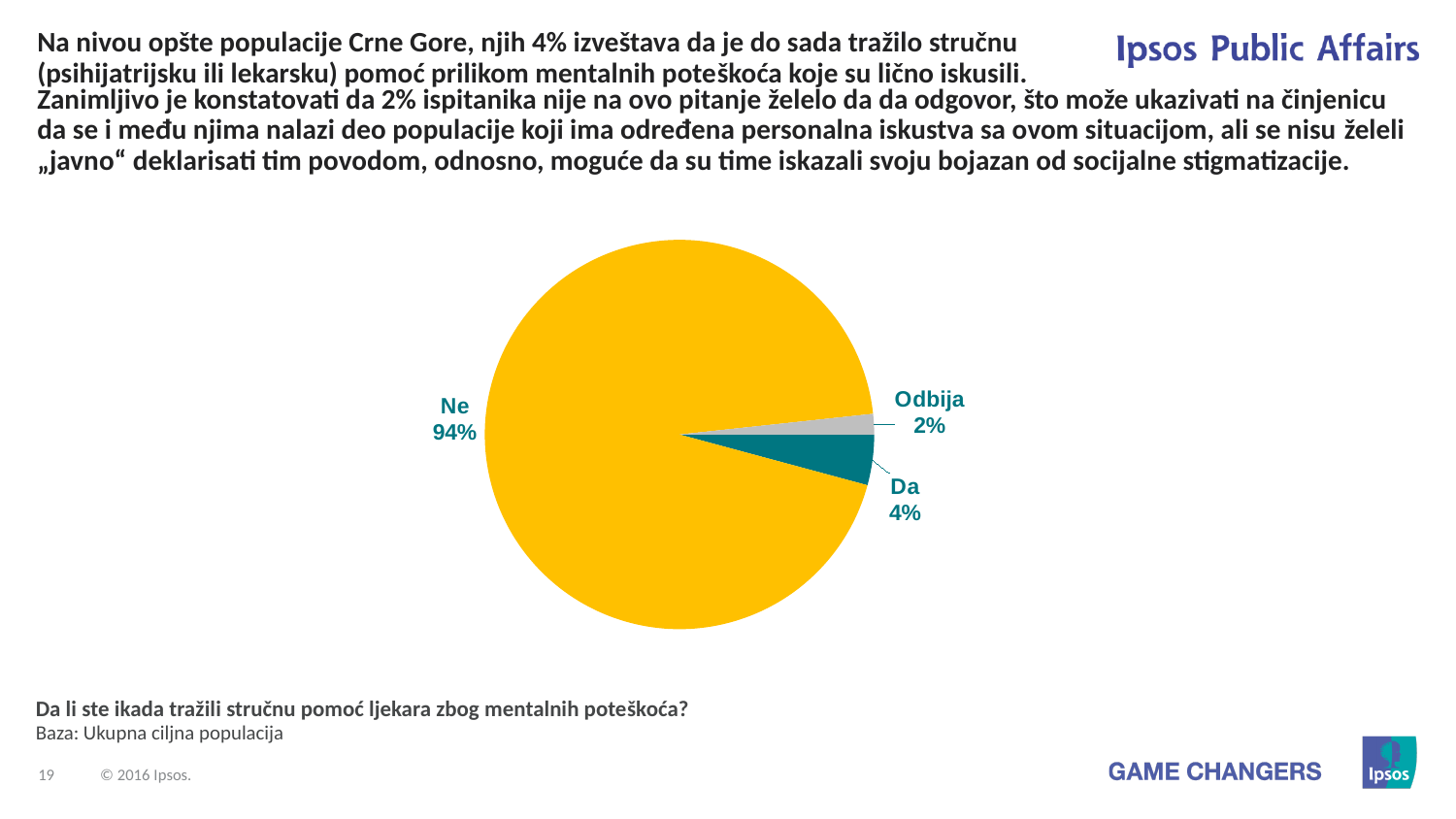
What share of the pie does the "Ne" slice represent? 94% Which slice of the pie is the largest? Ne What colour is the "Ne" slice of the pie? yellow What is the value shown for "Da"? 4% What kind of chart is shown on the slide? pie chart How many slices does the pie chart have? 3 Which slice of the pie is the smallest? Odbija What is the value shown for "Odbija"? 2% What is the difference between the "Ne" and "Da" values? 90% What is the difference between the "Da" and "Odbija" values? 2% What colour is the "Da" slice of the pie? teal Which is larger, the value for "Da" or the value for "Odbija"? Da